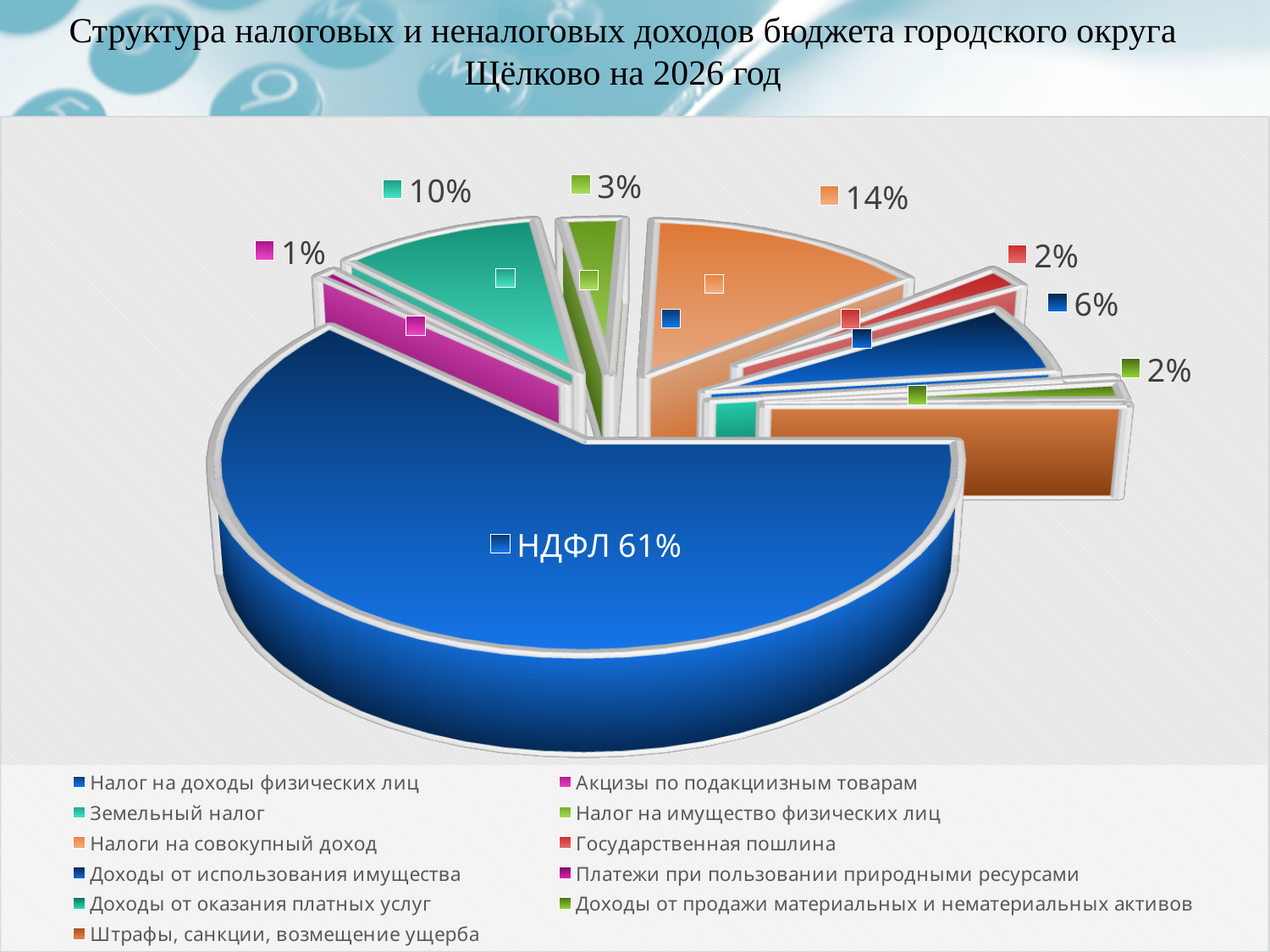
What percentage is shown for the dark blue slice, Доходы от использования имущества? 6% What percentage is shown for the teal slice, Земельный налог? 10% What percentage is shown for the orange slice, Налоги на совокупный доход? 14% Which category has the largest share of the pie? Налог на доходы физических лиц (НДФЛ) What year does the chart title refer to? 2026 Which slice is larger: Земельный налог or Налог на имущество физических лиц? Земельный налог What share of the pie is labelled НДФЛ? 61% What percentage is shown for the magenta slice, Акцизы по подакциизным товарам? 1% What percentage is shown for the red slice, Государственная пошлина? 2% What type of chart is shown on the slide? Pie chart What is the difference in percentage points between the 14% slice and the 10% slice? 4 percentage points How many categories does the legend list? 11